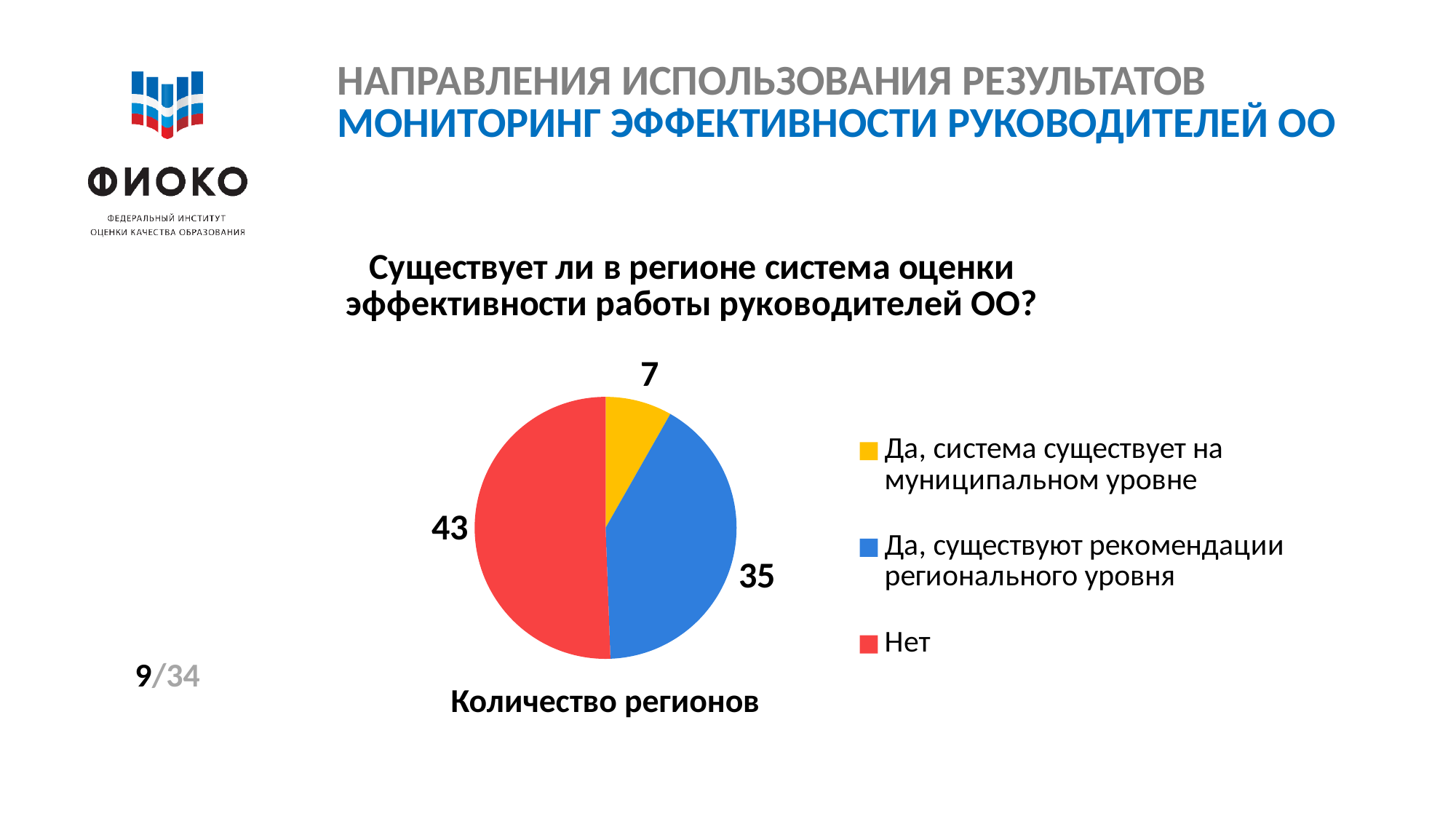
How many regions answered "Да, существуют рекомендации регионального уровня"? 35 Which is larger: the number of regions answering "Нет" or the number answering "Да, существуют рекомендации регионального уровня"? Нет Which answer has the largest slice of the pie? Нет How many slices does the pie chart have? 3 What is the difference between the number of regions answering "Да, существуют рекомендации регионального уровня" and those answering "Да, система существует на муниципальном уровне"? 28 Which answer has the smallest slice of the pie? Да, система существует на муниципальном уровне What is the total number of regions represented in the pie chart? 85 How many regions answered "Нет"? 43 How many regions answered "Да, система существует на муниципальном уровне"? 7 What colour is the slice for "Нет"? red What kind of chart is shown on the slide? pie chart What is the difference between the number of regions answering "Нет" and those answering "Да, существуют рекомендации регионального уровня"? 8